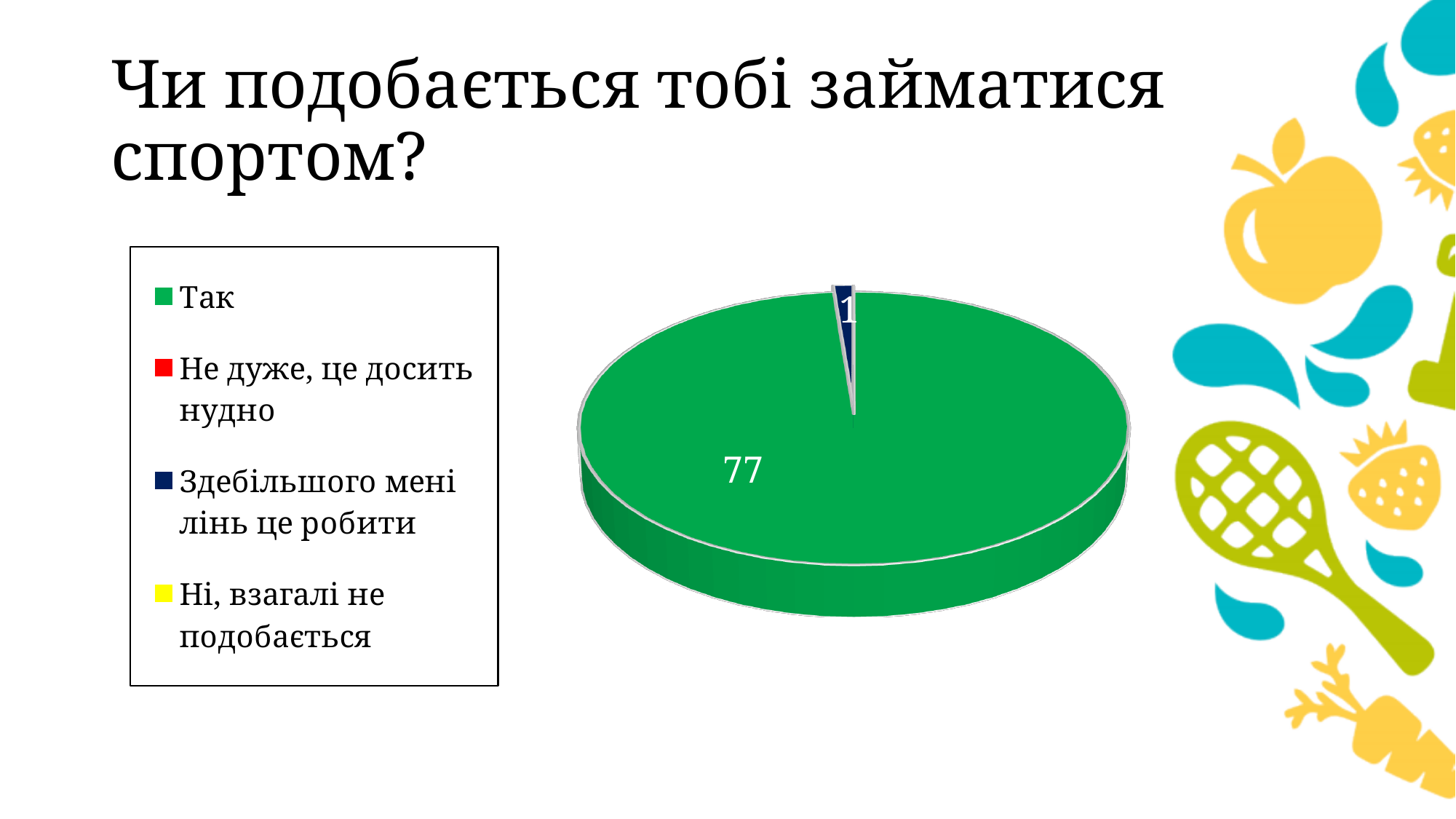
What value is shown for the "Здебільшого мені лінь це робити" slice of the pie chart? 1 How many slices of the pie chart have a data label printed on them? 2 How many categories does the legend of the pie chart list? 4 What value is shown for the "Так" slice of the pie chart? 77 What kind of chart is shown on the slide? Pie chart Which is larger, the value for "Так" or the value for "Здебільшого мені лінь це робити"? Так What is the title of the slide containing the pie chart? Чи подобається тобі займатися спортом? What colour represents the "Так" category in the pie chart? Green Which category has the largest slice in the pie chart? Так What is the difference between the values for "Так" and "Здебільшого мені лінь це робити"? 76